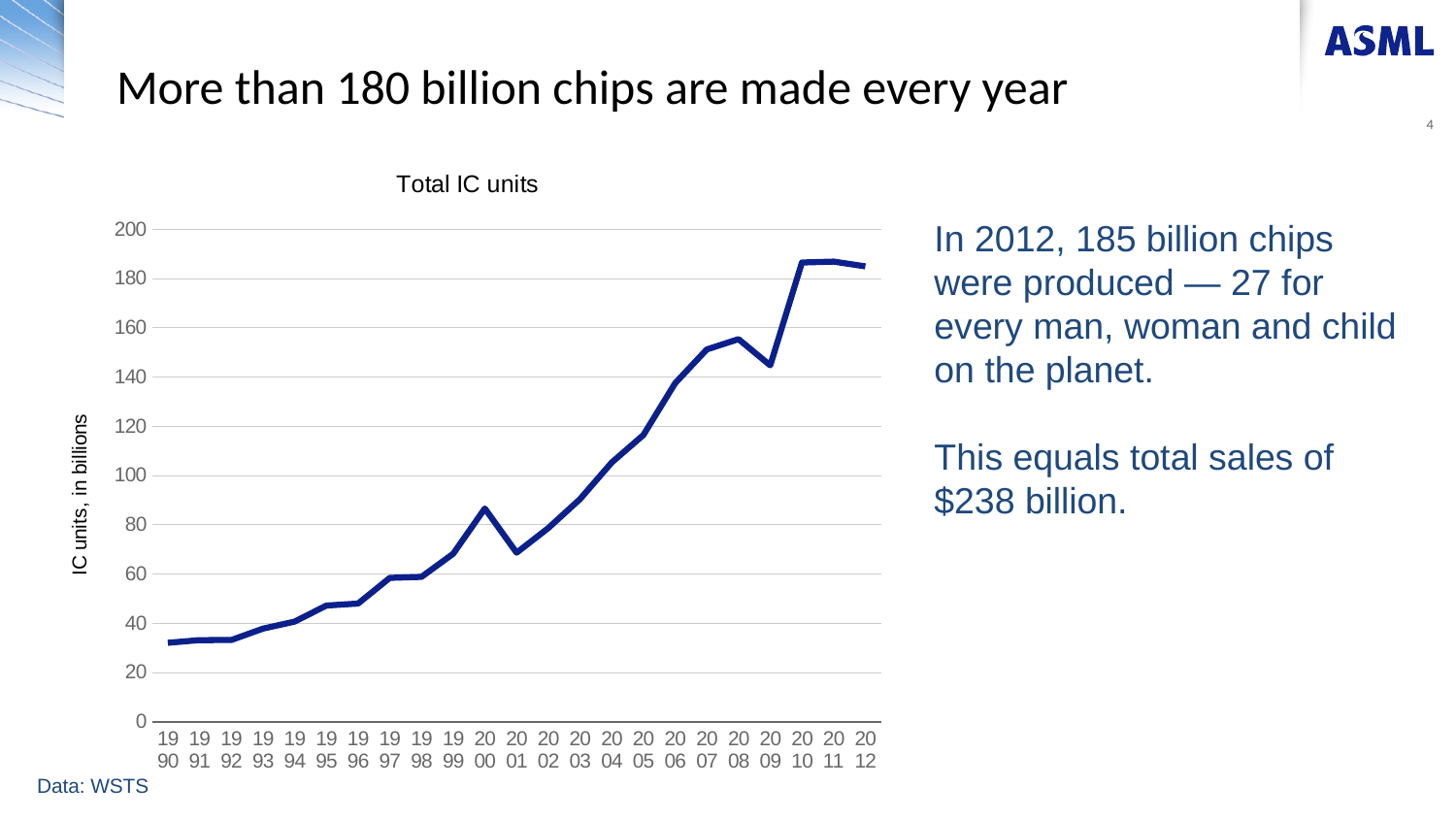
Is the value for 2008 greater or less than 140? greater What is the title of the chart? Total IC units Which year has the larger value, 2008 or 2009? 2008 Which year has the larger value, 2000 or 2001? 2000 Is the value for 2001 greater or less than 80? less Is the value for 2000 greater or less than 80? greater What kind of chart is shown on the slide? line chart Overall, do the values rise or fall from 1990 to 2012? rise How many years are plotted along the x axis of the chart? 23 What is the label on the vertical axis of the chart? IC units, in billions